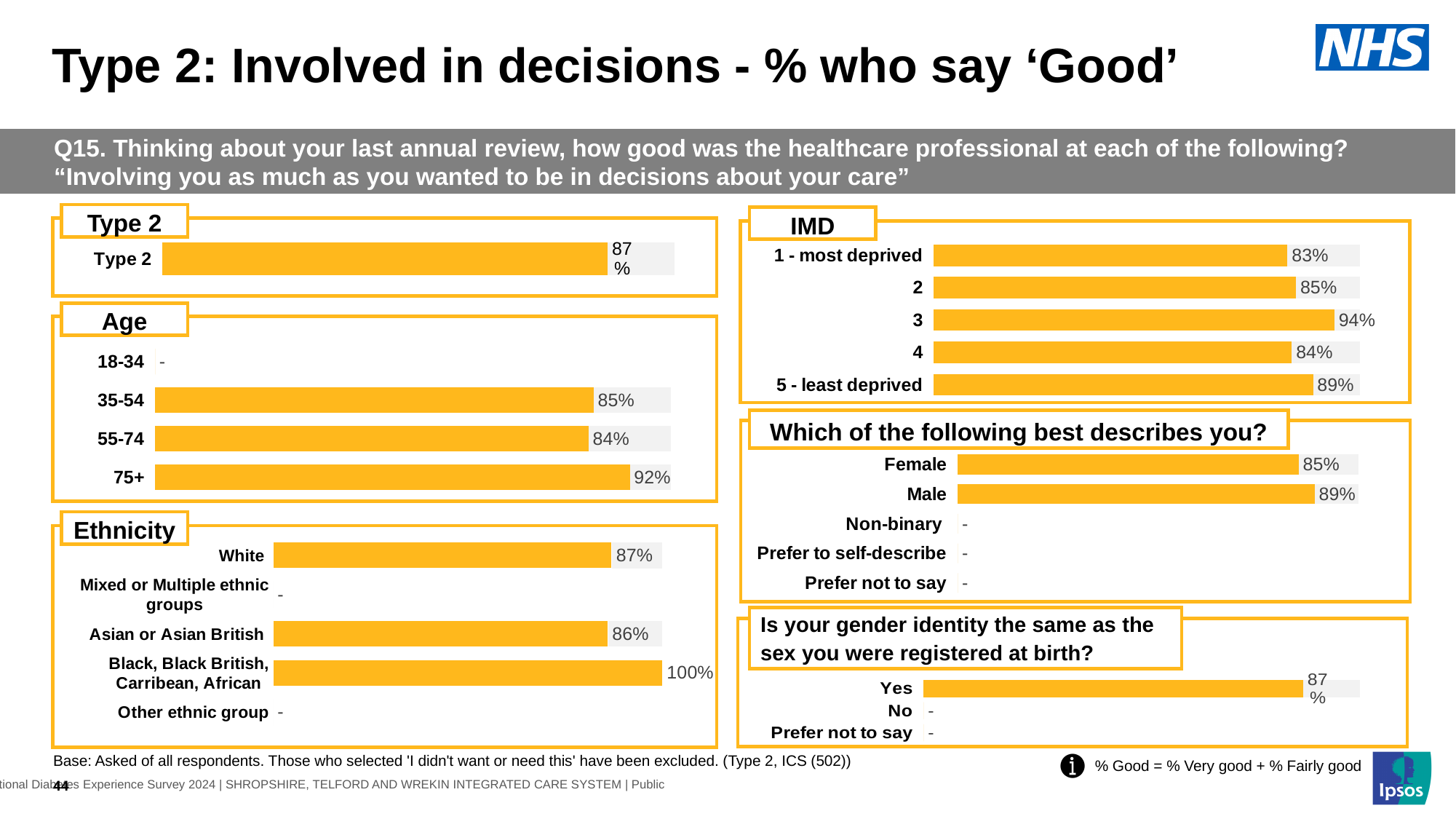
In the 'Is your gender identity the same as the sex you were registered at birth?' chart, what is the value for Yes? 87% In the Type 2 chart, what is the value for Type 2? 87% In the Age chart, how many age categories are listed? 4 In the Age chart, what is the value for 75+? 92% In the Ethnicity chart, what is the value for Black, Black British, Carribean, African? 100% In the Age chart, which category has the lowest printed value? 55-74 In the IMD chart, which category has the lowest value? 1 - most deprived What kind of chart is the IMD chart? Bar chart In the IMD chart, what is the difference between the values for 3 and 1 - most deprived? 11 percentage points In the 'Which of the following best describes you?' chart, which is larger, Female or Male? Male In the IMD chart, which category has the highest value? 3 In the Ethnicity chart, what is the difference between the values for White and Asian or Asian British? 1 percentage point